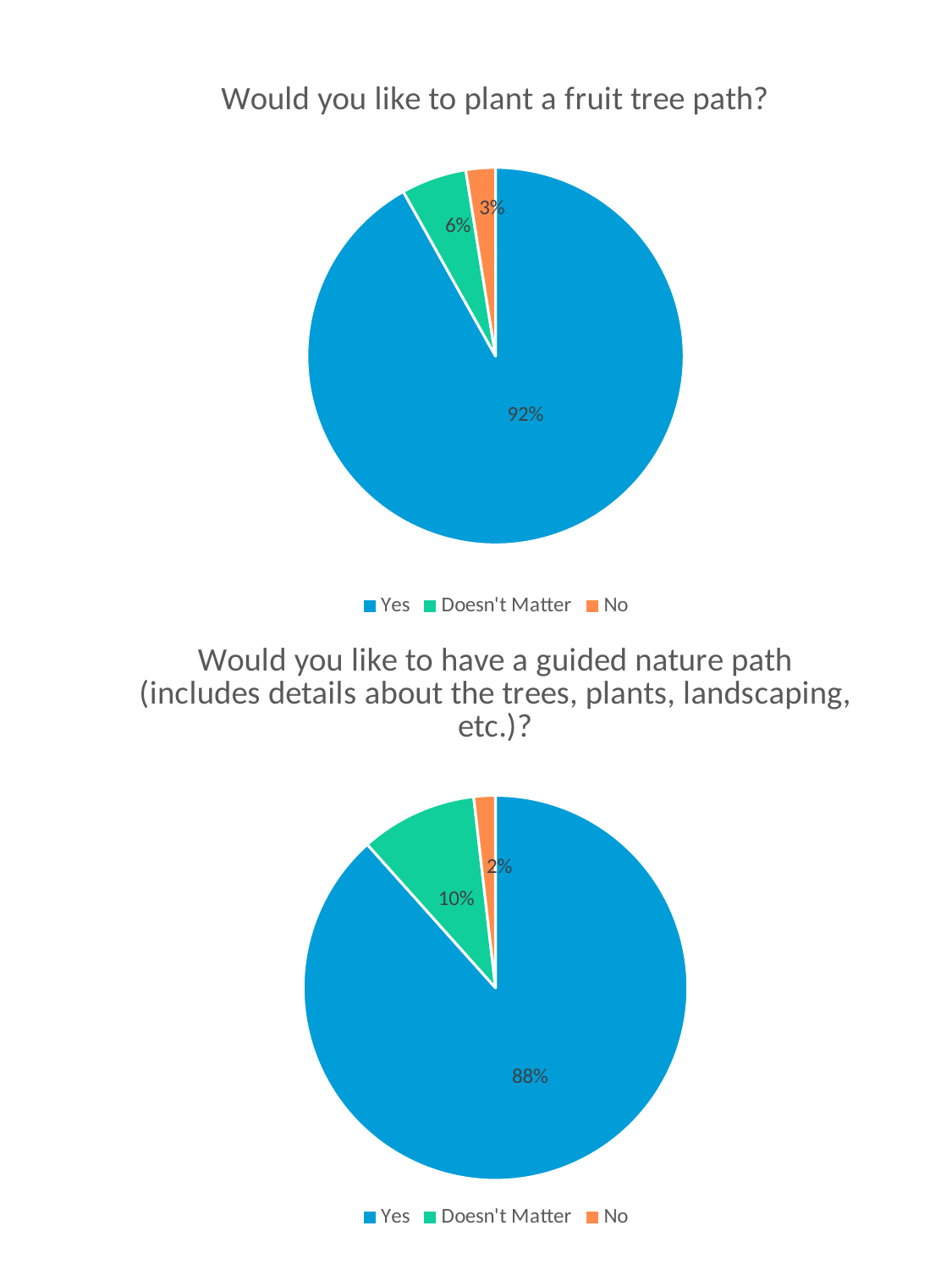
In the 'Would you like to have a guided nature path' chart, what share of responses is 'Doesn't Matter'? 10% In the 'Would you like to have a guided nature path' chart, which category has the largest slice? Yes In the 'Would you like to have a guided nature path' chart, what share of responses is 'No'? 2% In the 'Would you like to plant a fruit tree path?' chart, which category has the smallest slice? No In the 'Would you like to have a guided nature path' chart, what share of responses is 'Yes'? 88% What type of chart is the top chart on the slide? Pie chart In the 'Would you like to have a guided nature path' chart, which is larger: 'Doesn't Matter' or 'No'? Doesn't Matter In the 'Would you like to plant a fruit tree path?' chart, what share of responses is 'No'? 3% In the 'Would you like to plant a fruit tree path?' chart, what share of responses is 'Doesn't Matter'? 6% How many categories does the legend of the bottom chart list? 3 In the 'Would you like to plant a fruit tree path?' chart, what share of responses is 'Yes'? 92% In the 'Would you like to plant a fruit tree path?' chart, what is the difference between the 'Yes' and 'Doesn't Matter' shares? 86%